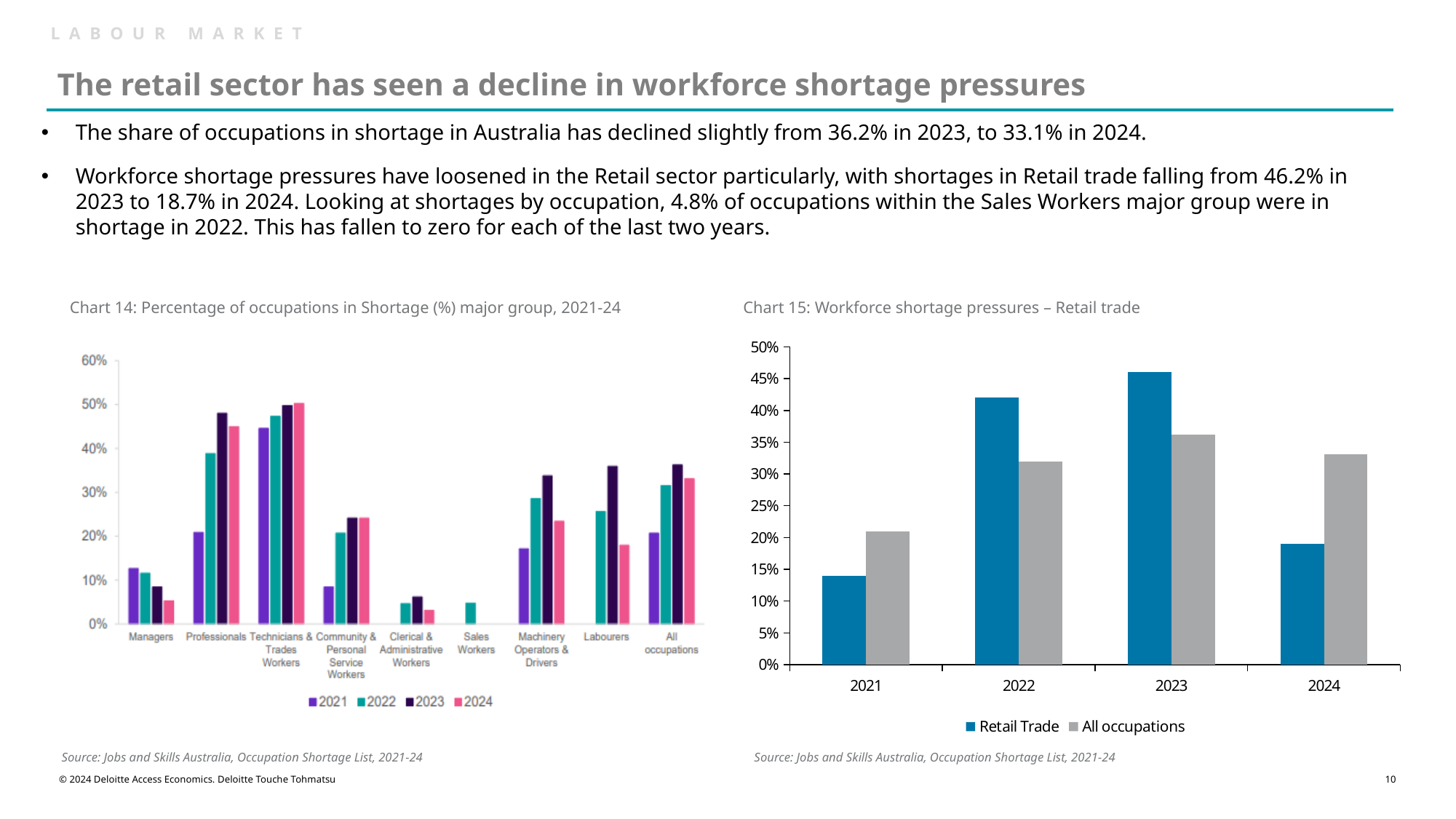
In Chart 14, do the values for Managers rise or fall from 2021 to 2024? Fall In Chart 15, which year has the lowest Retail Trade value? 2021 How many series does the legend of Chart 14 list? 4 How many occupation groups are shown on the x axis of Chart 14? 9 In Chart 14, which occupation group has the highest 2024 value? Technicians & Trades Workers In Chart 15, is the Retail Trade value for 2021 greater or less than 15%? less In Chart 15, for 2024, which is larger: Retail Trade or All occupations? All occupations How many series does the legend of Chart 15 list? 2 What kind of chart is Chart 15: Workforce shortage pressures – Retail trade? Bar chart In Chart 15, is the Retail Trade value for 2022 greater or less than 40%? greater In Chart 15, which year has the highest Retail Trade value? 2023 How many years are shown on the x axis of Chart 15? 4